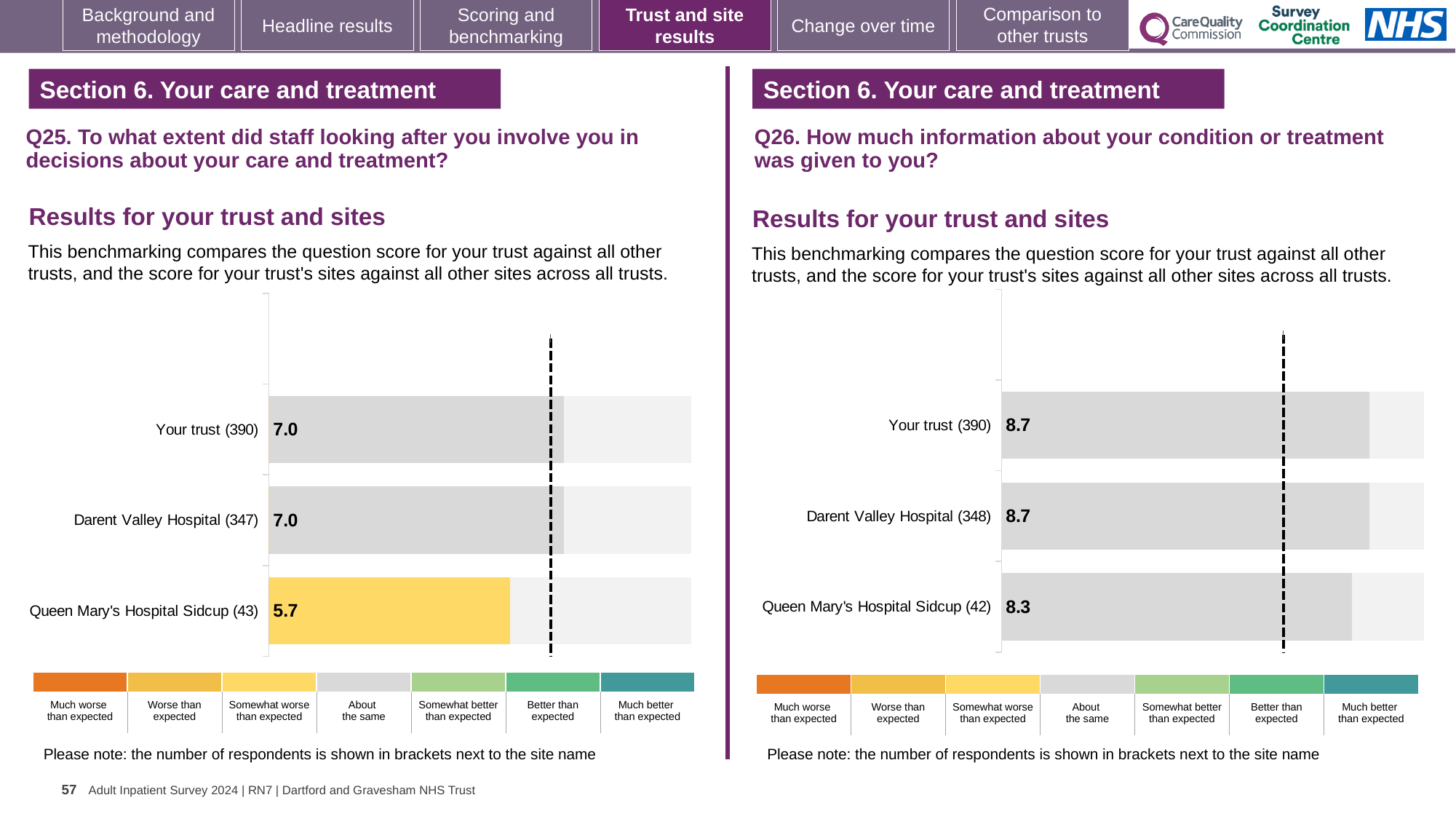
On the Q25 chart (left), which benchmarking category does the yellow colour of the Queen Mary's Hospital Sidcup bar represent? Somewhat worse than expected How many sites or trust rows are plotted on the Q25 chart (left)? 3 On the Q26 chart (right), which is larger: the score for Darent Valley Hospital (348) or the score for Queen Mary's Hospital Sidcup (42)? Darent Valley Hospital (348) On the Q26 chart (right), which site has the lowest score? Queen Mary's Hospital Sidcup (42) On the Q25 chart (left), what is the score for Queen Mary's Hospital Sidcup (43)? 5.7 On the Q26 chart (right), what is the score for Queen Mary's Hospital Sidcup (42)? 8.3 On the Q26 chart (right), what is the score for Darent Valley Hospital (348)? 8.7 On the Q26 chart (right), what is the difference between the score for Your trust (390) and the score for Queen Mary's Hospital Sidcup (42)? 0.4 On the Q25 chart (left), which site has the lowest score? Queen Mary's Hospital Sidcup (43) What kind of chart is used on the Q26 chart (right)? Bar chart On the Q25 chart (left), what is the difference between the score for Darent Valley Hospital (347) and the score for Queen Mary's Hospital Sidcup (43)? 1.3 On the Q25 chart (left), what is the score for Your trust (390)? 7.0